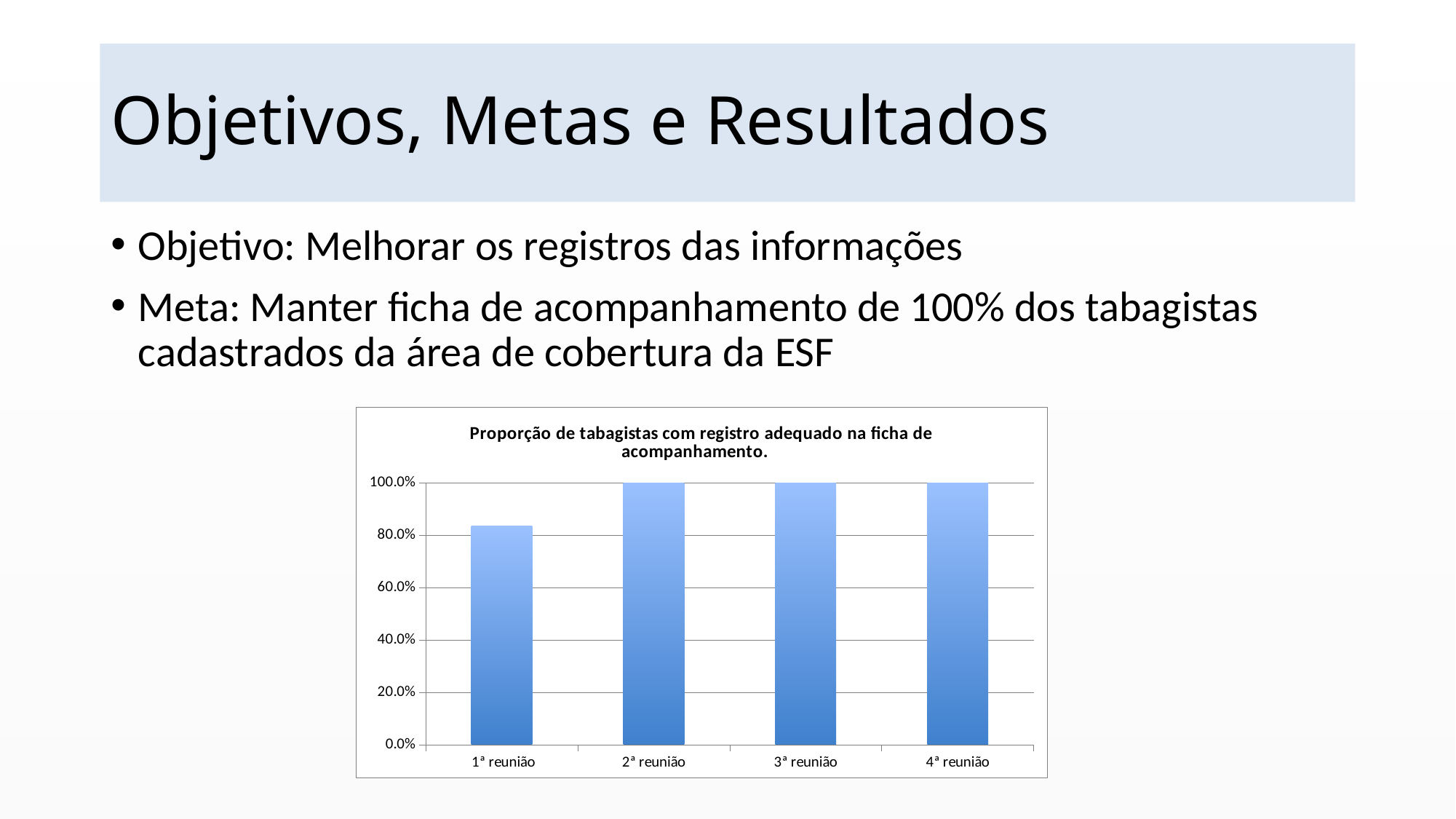
What kind of chart is shown on the slide? bar chart Do the values rise or fall from 1ª reunião to 2ª reunião? rise What is the value for 4ª reunião? 100.0% Which category has the lowest value? 1ª reunião What is the value for 3ª reunião? 100.0% What is the highest value shown on the y axis of the chart? 100.0% Which is larger, the value for 1ª reunião or the value for 2ª reunião? 2ª reunião What is the title of the chart? Proporção de tabagistas com registro adequado na ficha de acompanhamento. What is the value for 2ª reunião? 100.0% Is the value for 1ª reunião greater or less than 100.0%? less How many categories are shown on the x axis of the chart? 4 Is the value for 1ª reunião greater or less than 80.0%? greater